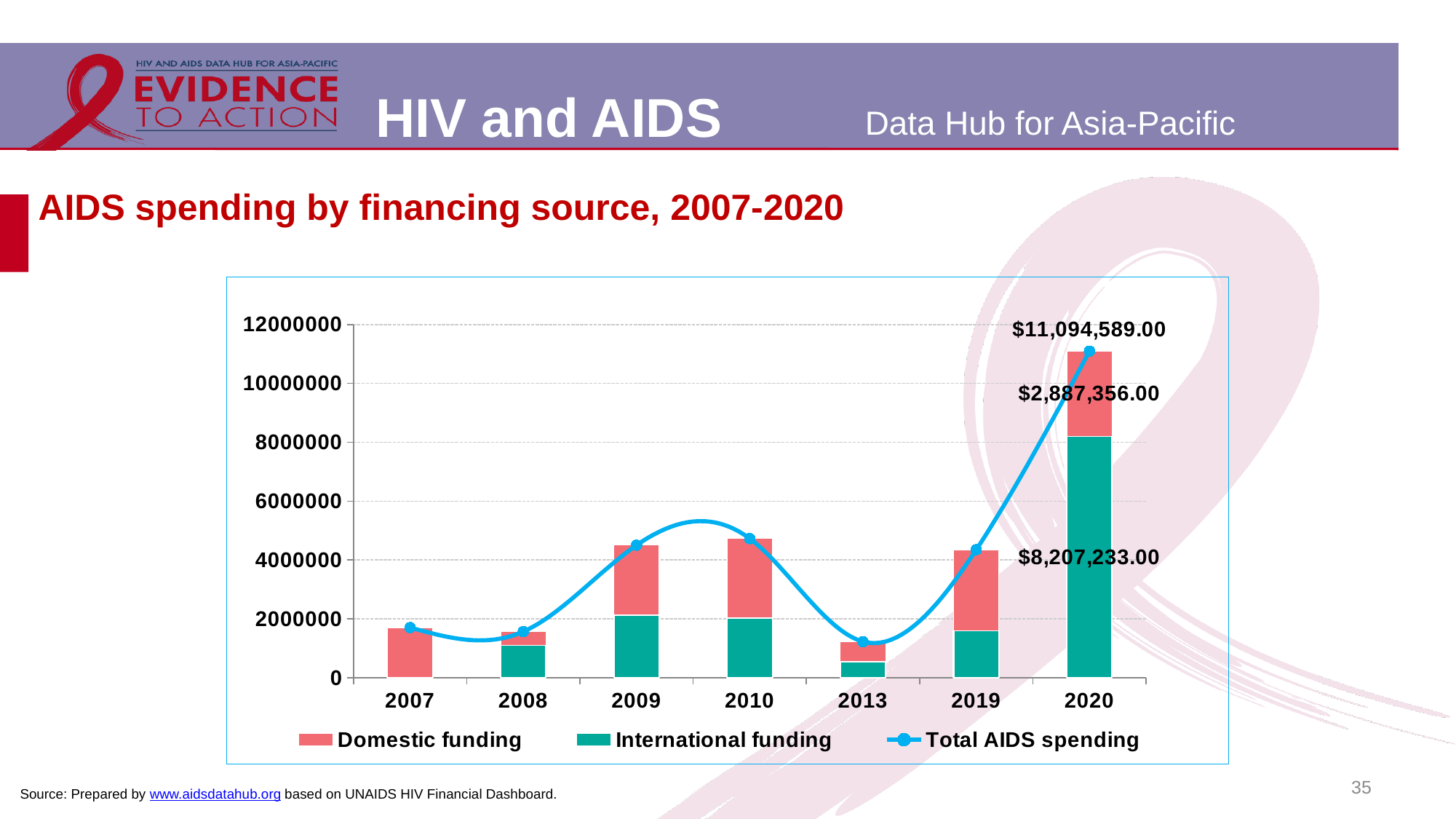
What is the International funding value shown for 2020? $8,207,233.00 Is the Total AIDS spending for 2009 greater or less than 4000000? greater What is the Domestic funding value shown for 2020? $2,887,356.00 What is the difference between International funding and Domestic funding in 2020? $5,319,877.00 Is the Total AIDS spending for 2013 greater or less than 2000000? less Does Total AIDS spending rise or fall from 2013 to 2020? rise Which year has the lowest Total AIDS spending? 2013 How many years are shown on the x axis of the chart? 7 How many series does the chart legend list? 3 Which year has the highest Total AIDS spending? 2020 What is the Total AIDS spending value labelled for 2020? $11,094,589.00 In 2020, which is larger: Domestic funding or International funding? International funding